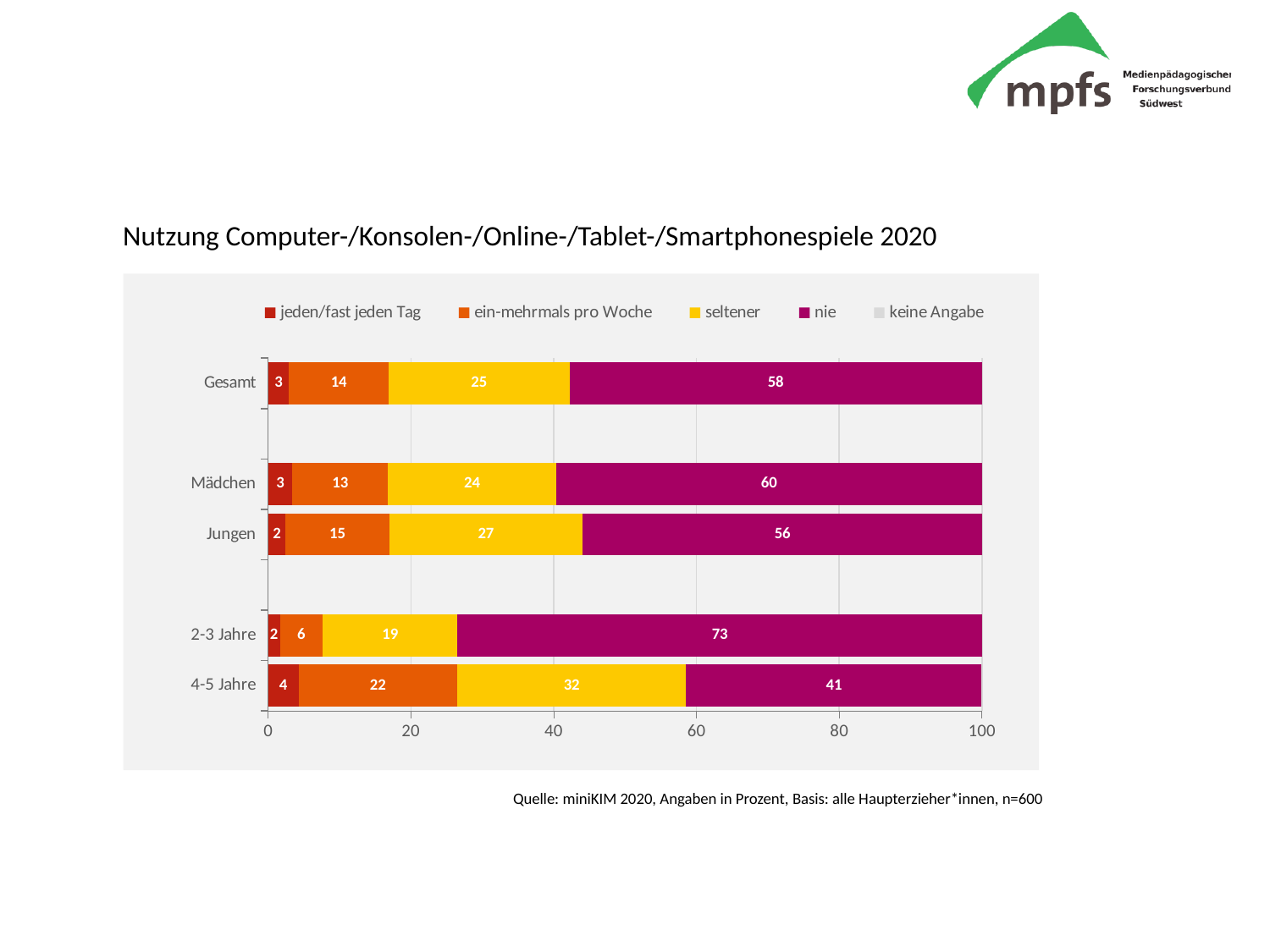
How many categories are shown on the y axis? 5 What is the value of "seltener" for Jungen? 27 Which has the larger "seltener" value, Mädchen or Jungen? Jungen What is the value of "nie" for 2-3 Jahre? 73 Which category has the lowest value for "nie"? 4-5 Jahre What is the difference between the "nie" values for 2-3 Jahre and 4-5 Jahre? 32 What is the value of "jeden/fast jeden Tag" for Gesamt? 3 What is the value of "ein-mehrmals pro Woche" for 4-5 Jahre? 22 What kind of chart is shown on the slide? Stacked bar chart Which category has the highest value for "nie"? 2-3 Jahre What is the difference between the "nie" values for Mädchen and Jungen? 4 How many series does the legend list? 5